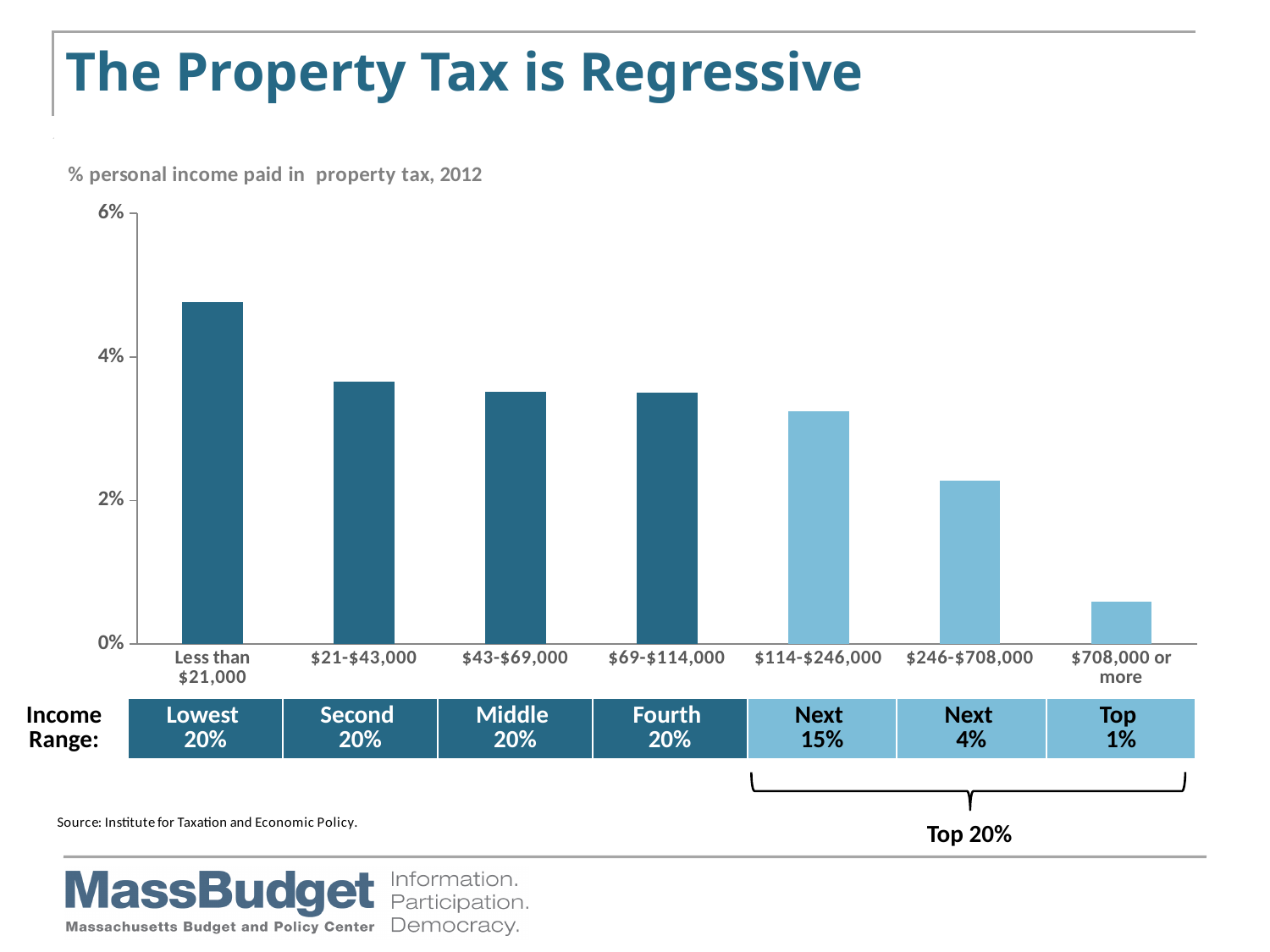
Is the value for the $114-$246,000 income range greater or less than 2%? greater Which pays a larger share of income in property tax: the Less than $21,000 range or the $21-$43,000 range? Less than $21,000 What is the source cited for the chart data? Institute for Taxation and Economic Policy Is the value for the $21-$43,000 income range greater or less than 4%? less Which income range pays the lowest share of personal income in property tax? $708,000 or more Is the value for the $708,000 or more income range greater or less than 2%? less Which income range pays the highest share of personal income in property tax? Less than $21,000 Which pays a larger share of income in property tax: the $246-$708,000 range or the $708,000 or more range? $246-$708,000 What kind of chart is shown on the slide? bar chart How many income-range categories are plotted in the chart? 7 Do the bar values rise or fall as income range increases from left to right? fall